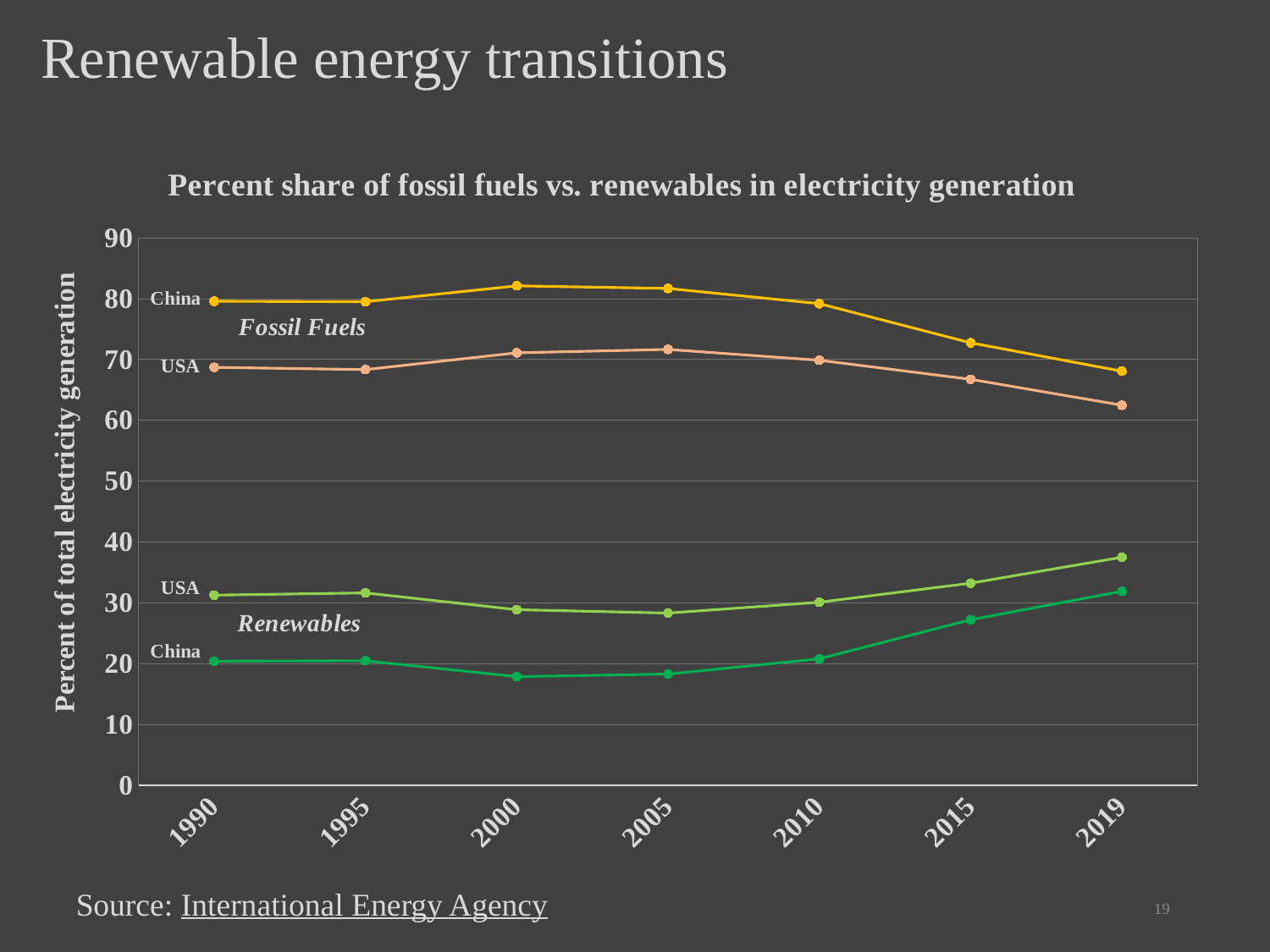
What kind of chart is shown on the slide? line chart What is the title of the chart? Percent share of fossil fuels vs. renewables in electricity generation Is the value for USA Fossil Fuels in 2019 greater or less than 60? greater In 2010, which is larger: the fossil fuel share for China or for USA? China How many years are plotted along the x axis? 7 How many lines (series) are plotted on the chart? 4 Is the value for USA Renewables in 2019 greater or less than 40? less Is the value for China Renewables in 2000 greater or less than 20? less Does the China Fossil Fuels line rise or fall from 2005 to 2019? fall What is the label of the y axis? Percent of total electricity generation In which year is the China Renewables line at its highest? 2019